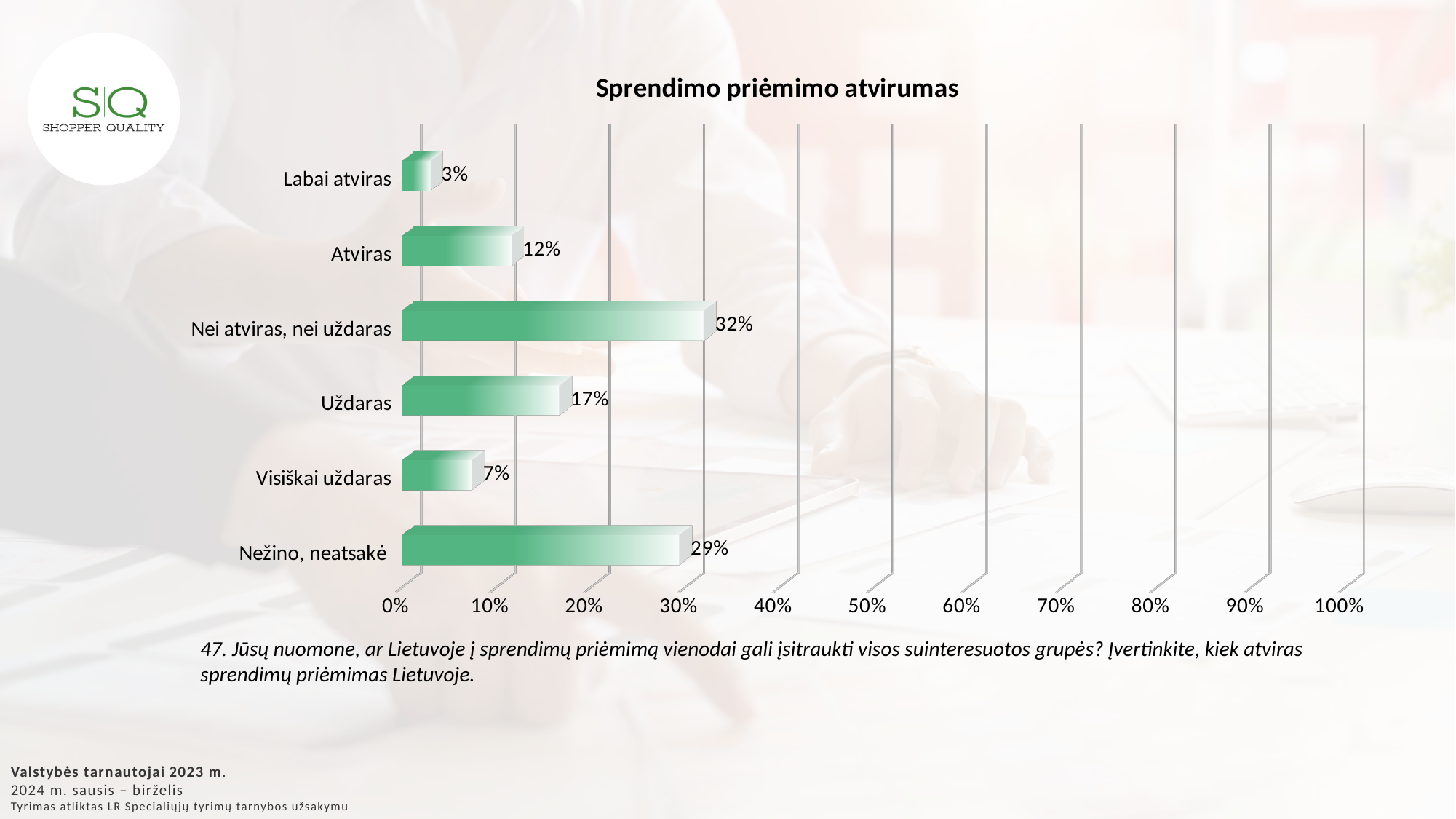
Which category has the highest value? Nei atviras, nei uždaras What is the difference between the values for "Atviras" and "Labai atviras"? 9% What is the title of the chart? Sprendimo priėmimo atvirumas Is the value for "Nežino, neatsakė" greater or less than 20%? greater What is the value for "Nežino, neatsakė"? 29% What is the value for "Nei atviras, nei uždaras"? 32% Which is larger, the value for "Uždaras" or the value for "Visiškai uždaras"? Uždaras Which category has the lowest value? Labai atviras How many categories are shown in the chart? 6 What is the value for "Uždaras"? 17% What kind of chart is shown on the slide? Bar chart What is the value for "Labai atviras"? 3%